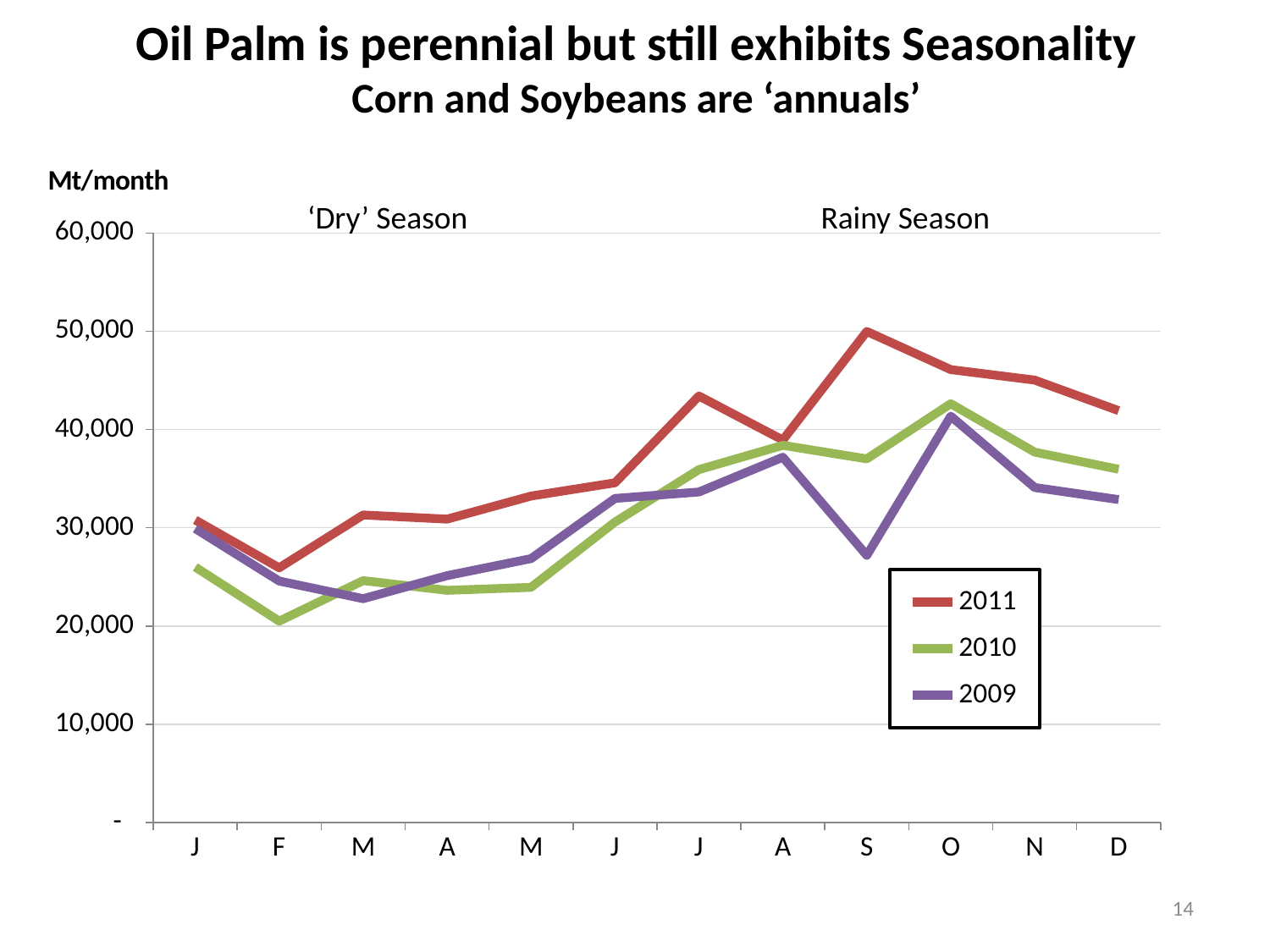
Is the value for 2009 in S greater or less than 30,000? less How many months are plotted along the x axis? 12 Is the value for 2011 in F greater or less than 30,000? less Does the 2011 series rise or fall from S to D? fall In S, which series has the larger value, 2011 or 2009? 2011 In which month does the 2009 series reach its highest value? O In which month does the 2010 series reach its lowest value? F What kind of chart is shown on the slide? line chart What unit is shown on the y axis label? Mt/month In which month does the 2011 series reach its highest value? S Is the value for 2011 in the second J (July) greater or less than 40,000? greater How many series does the legend list? 3